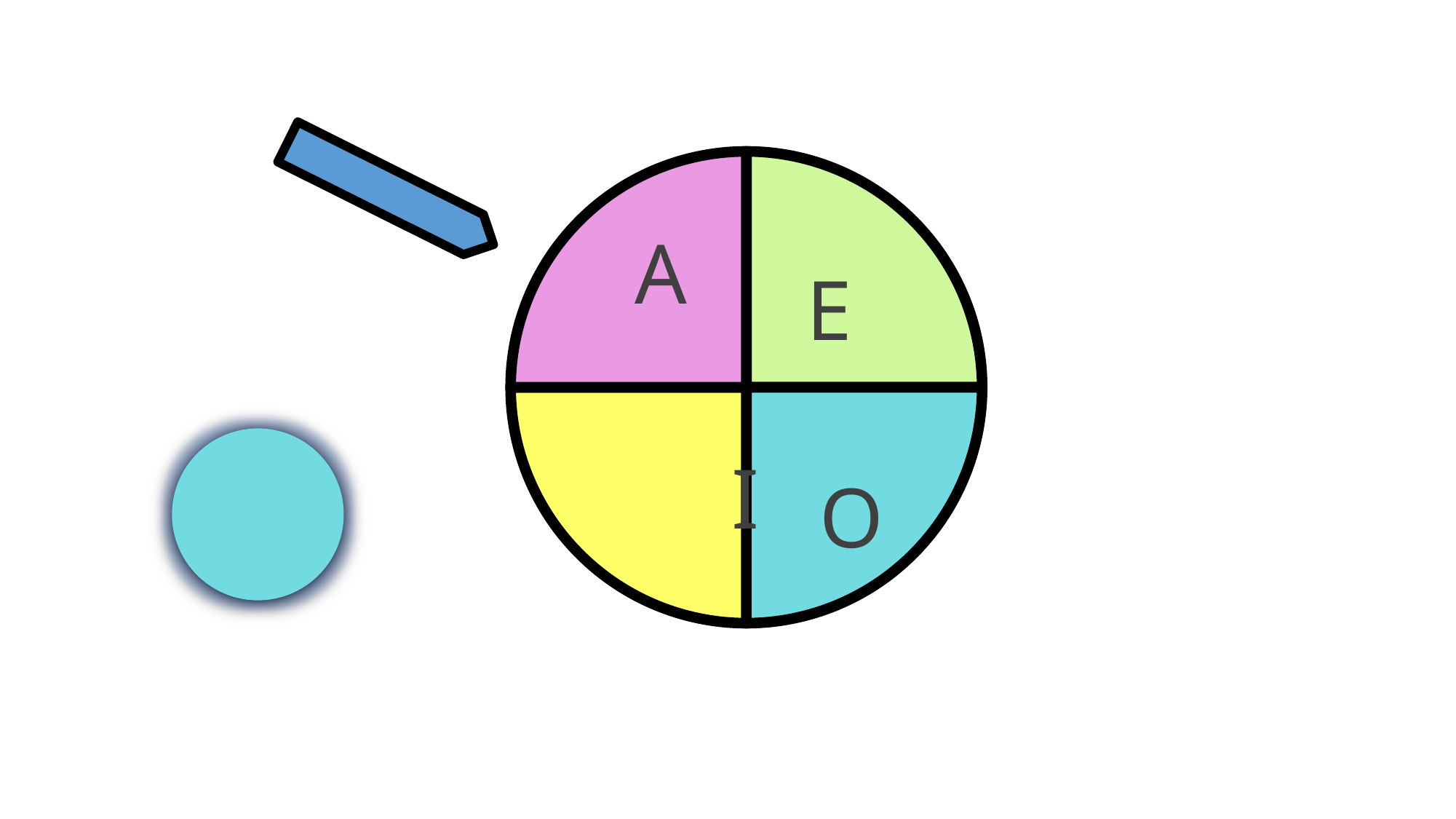
What kind of chart is shown on the slide? pie chart Are the four slices of the pie chart equal in size? yes How many slices does the pie chart have? 4 What colour is the slice labelled A in the pie chart? pink What are the labels of the four slices of the pie chart? A, E, I, O Which slice of the pie chart is yellow? I